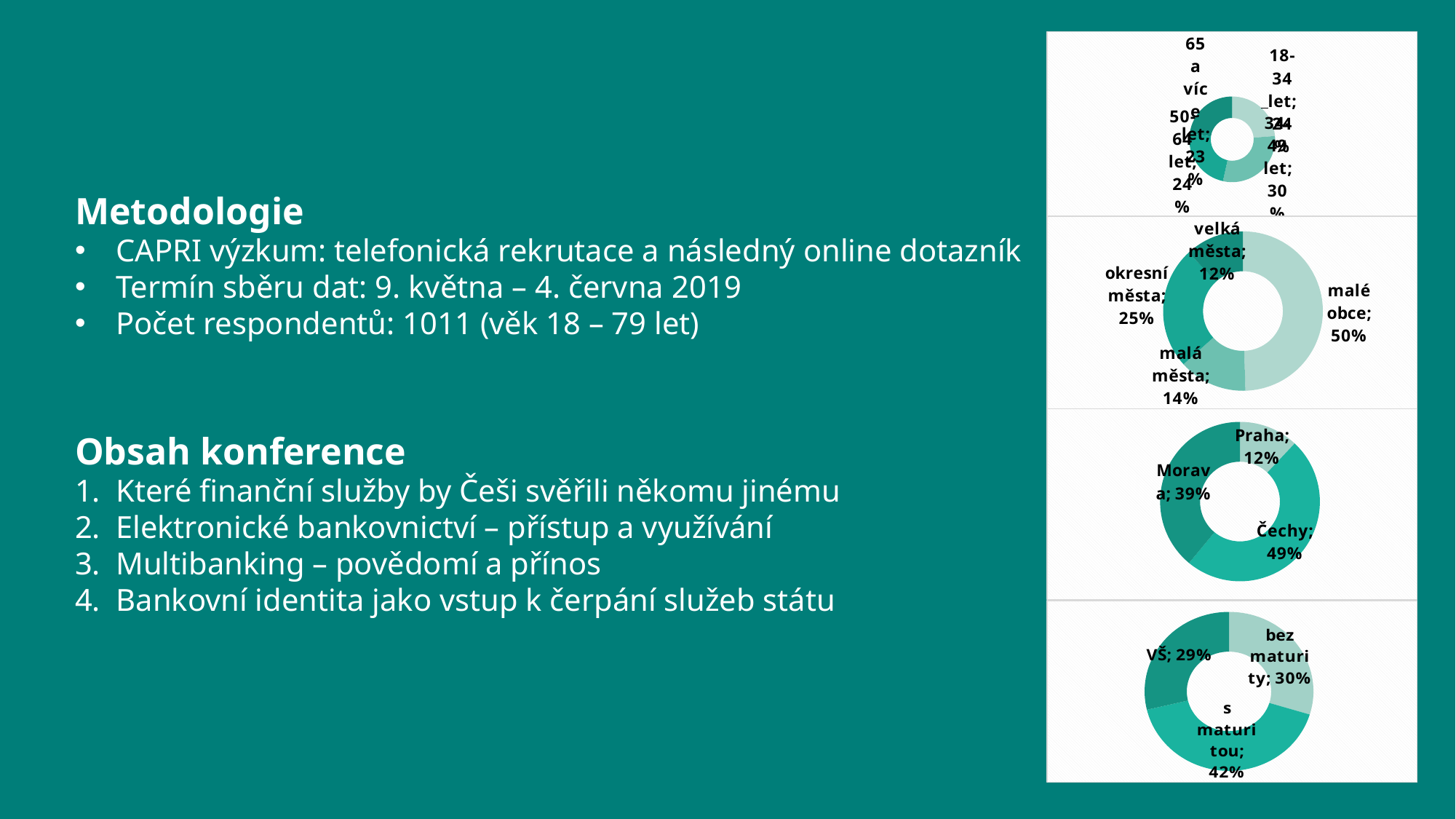
In the third doughnut chart from the top on the right, which is larger, the share for "Praha" or for "Morava"? Morava In the third doughnut chart from the top on the right, which category has the largest share? Čechy In the second doughnut chart from the top on the right, what is the difference between the shares for "okresní města" and "malá města"? 11% In the bottom doughnut chart on the right, what is the difference between the shares for "s maturitou" and "bez maturity"? 12% In the second doughnut chart from the top on the right, how many categories are shown? 4 In the bottom doughnut chart on the right, what share is labelled for "s maturitou"? 42% In the second doughnut chart from the top on the right, what share is labelled for "okresní města"? 25% In the third doughnut chart from the top on the right, what share is labelled for "Morava"? 39% In the second doughnut chart from the top on the right, which category has the smallest share? velká města What type of chart is the bottom chart on the right side of the slide? doughnut chart In the bottom doughnut chart on the right, what share is labelled for "VŠ"? 29% In the second doughnut chart from the top on the right, what share is labelled for "malé obce"? 50%